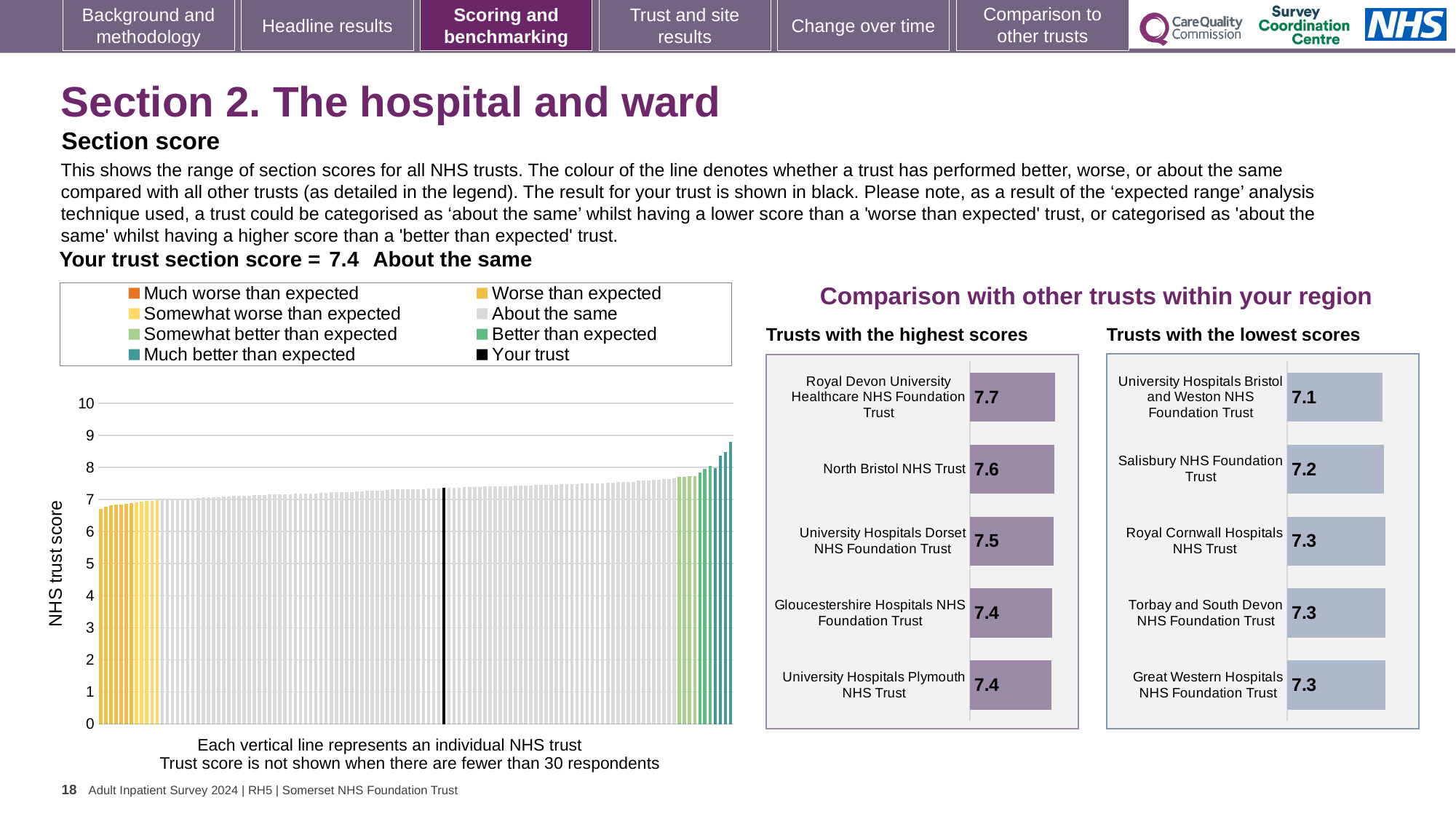
In the 'Trusts with the highest scores' chart, what is the score for Royal Devon University Healthcare NHS Foundation Trust? 7.7 In the 'Trusts with the highest scores' chart, which has the larger score: North Bristol NHS Trust or University Hospitals Dorset NHS Foundation Trust? North Bristol NHS Trust In the 'Trusts with the highest scores' chart, what is the difference between the scores of Royal Devon University Healthcare NHS Foundation Trust and University Hospitals Plymouth NHS Trust? 0.3 What is the title above the two small bar charts on the right of the slide? Comparison with other trusts within your region In the 'Trusts with the highest scores' chart, which trust has the highest score? Royal Devon University Healthcare NHS Foundation Trust What kind of chart is the NHS trust score chart on the left of the slide? Bar chart In the NHS trust score chart on the left, do the values rise or fall from left to right? Rise How many trusts are shown in the 'Trusts with the highest scores' chart? 5 In the 'Trusts with the lowest scores' chart, which trust has the lowest score? University Hospitals Bristol and Weston NHS Foundation Trust In the 'Trusts with the lowest scores' chart, what is the score for Salisbury NHS Foundation Trust? 7.2 In the NHS trust score chart on the left, is the value of the tallest bar greater or less than 8? greater How many entries does the legend of the NHS trust score chart on the left list? 8